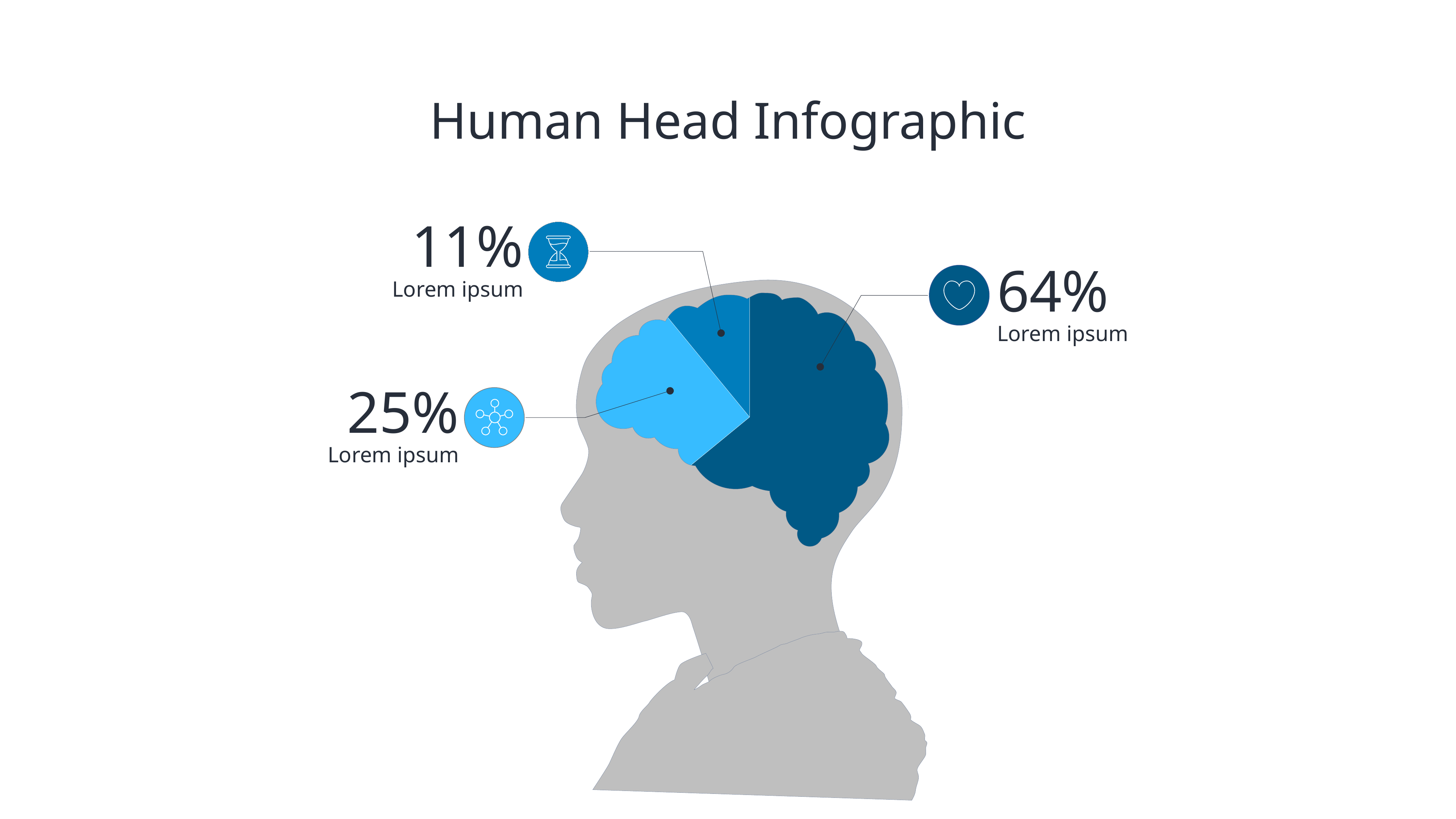
Which percentage value is the smallest among the brain segments? 11% Which colour is used for the largest (64%) segment of the brain? Dark blue What percentage is shown for the segment marked with the molecule/network icon? 25% What percentage is shown for the segment marked with the heart icon? 64% What percentage is shown for the segment marked with the hourglass icon? 11% What do the three percentages shown on the brain add up to? 100% Which is larger, the value for the hourglass icon segment or the value for the molecule icon segment? The molecule icon segment (25%) What is the difference in percentage points between the 64% segment and the 25% segment? 39 Which percentage value is the largest among the brain segments? 64% How many segments is the brain divided into? 3 What is the difference in percentage points between the 25% segment and the 11% segment? 14 What is the title of the slide? Human Head Infographic